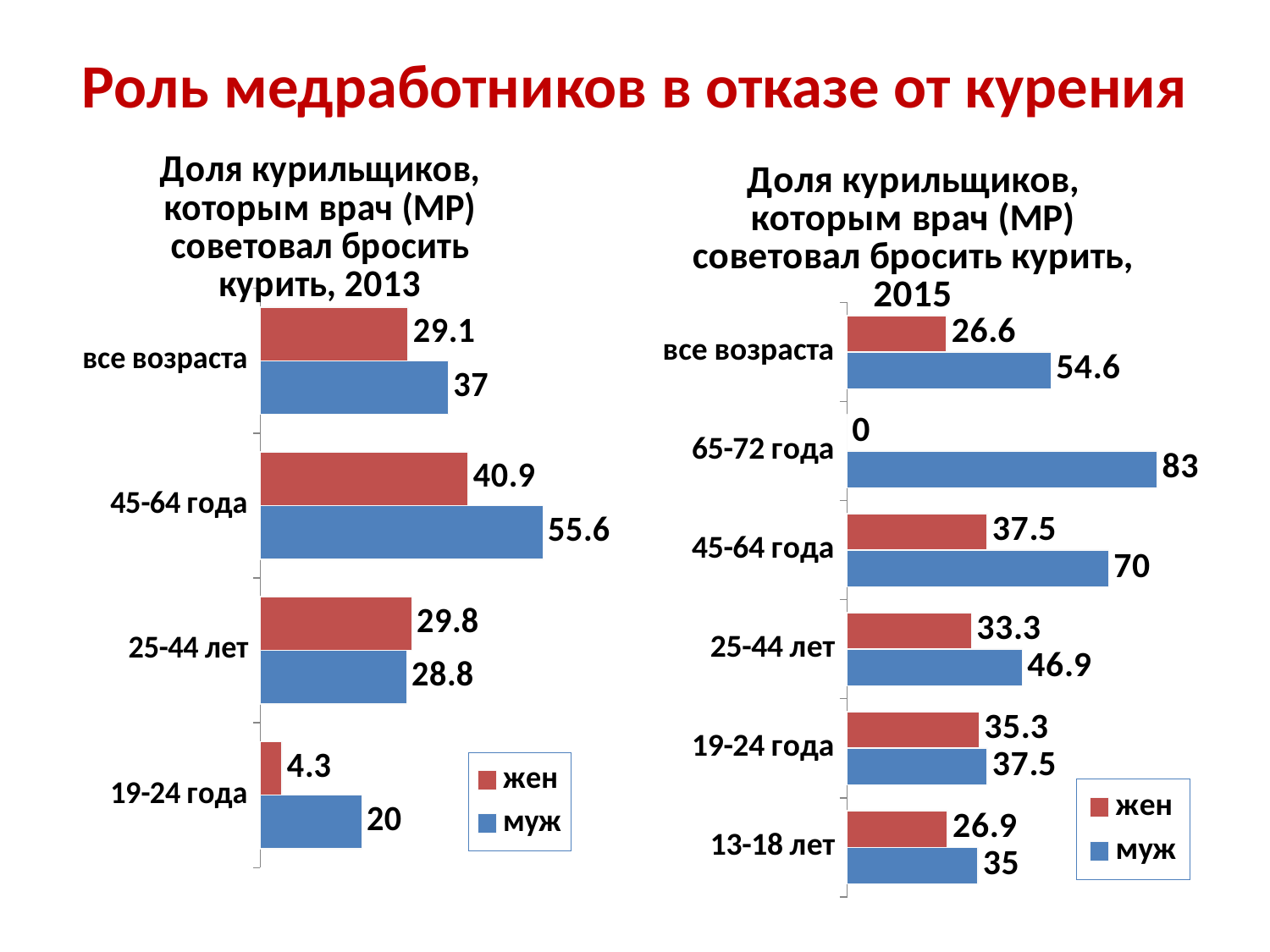
In the 2015 chart (right), which colour represents the муж series? blue In the 2013 chart (left), which category has the lowest value for жен? 19-24 года In the 2013 chart (left), what is the value for жен in the 19-24 года category? 4.3 In the 2015 chart (right), which category has the highest value for муж? 65-72 года In the 2015 chart (right), what is the value for муж in the 65-72 года category? 83 In the 2015 chart (right), what is the difference between муж and жен in the 45-64 года category? 32.5 In the 2013 chart (left), which is larger in the 25-44 лет category, жен or муж? жен How many series does the legend of the 2013 chart (left) list? 2 In the 2013 chart (left), what is the value for муж in the 45-64 года category? 55.6 What type of chart is the 2013 chart (left)? bar chart How many categories are shown in the 2015 chart (right)? 6 In the 2015 chart (right), what is the value for жен in the 25-44 лет category? 33.3